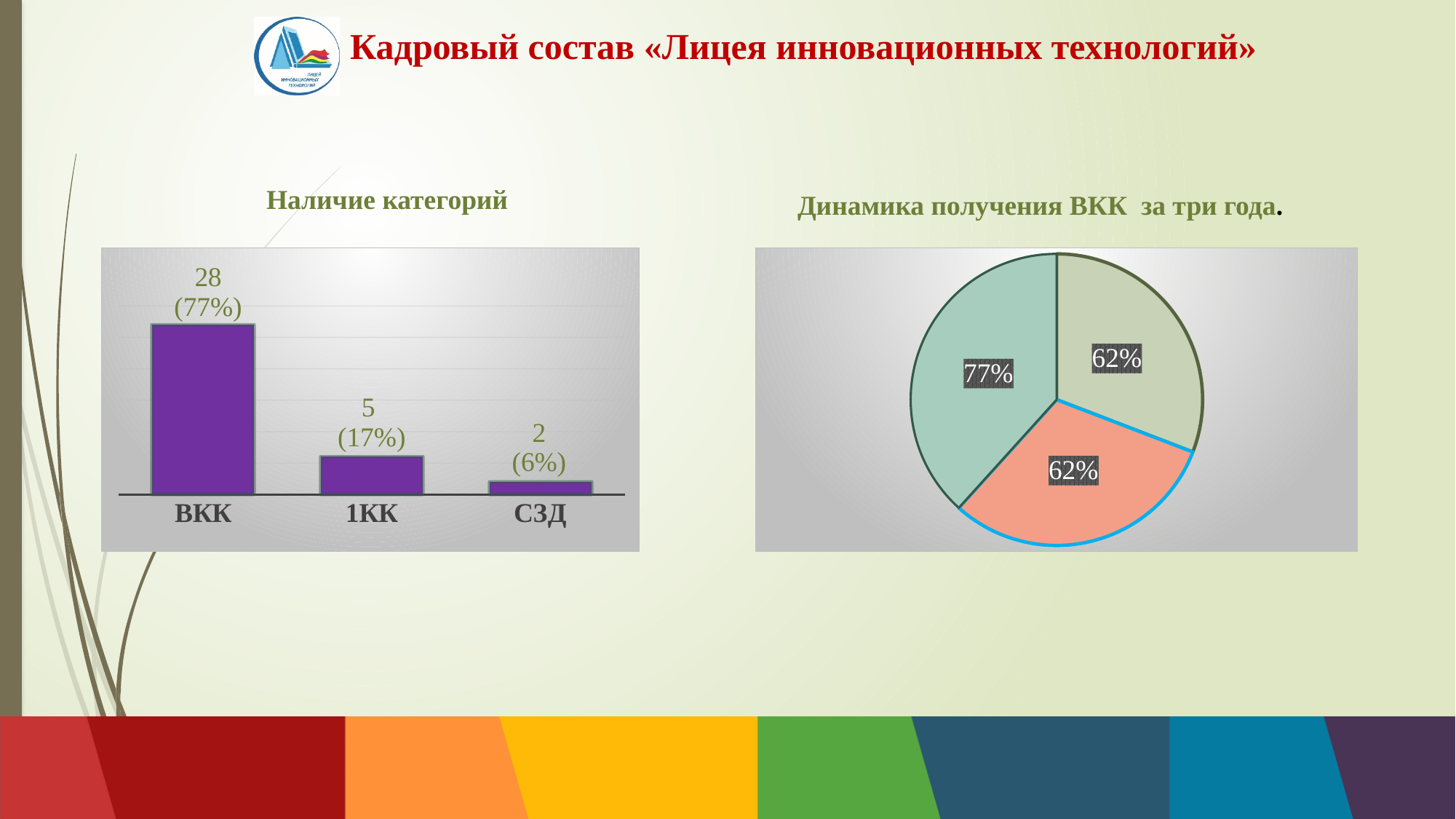
In the bar chart 'Наличие категорий', how many categories are shown? 3 In the bar chart 'Наличие категорий', which category has the highest value? ВКК In the bar chart 'Наличие категорий', what is the value for ВКК? 28 (77%) In the bar chart 'Наличие категорий', what is the value for СЗД? 2 (6%) In the bar chart 'Наличие категорий', which is larger, the value for 1КК or the value for СЗД? 1КК In the bar chart 'Наличие категорий', which category has the lowest value? СЗД In the bar chart 'Наличие категорий', what is the difference between the counts for ВКК and 1КК? 23 In the bar chart 'Наличие категорий', what is the value for 1КК? 5 (17%) In the pie chart 'Динамика получения ВКК за три года', what percentage is printed on the orange slice? 62% What kind of chart is 'Динамика получения ВКК за три года'? Pie chart What kind of chart is 'Наличие категорий'? Bar chart In the pie chart 'Динамика получения ВКК за три года', how many slices are there? 3